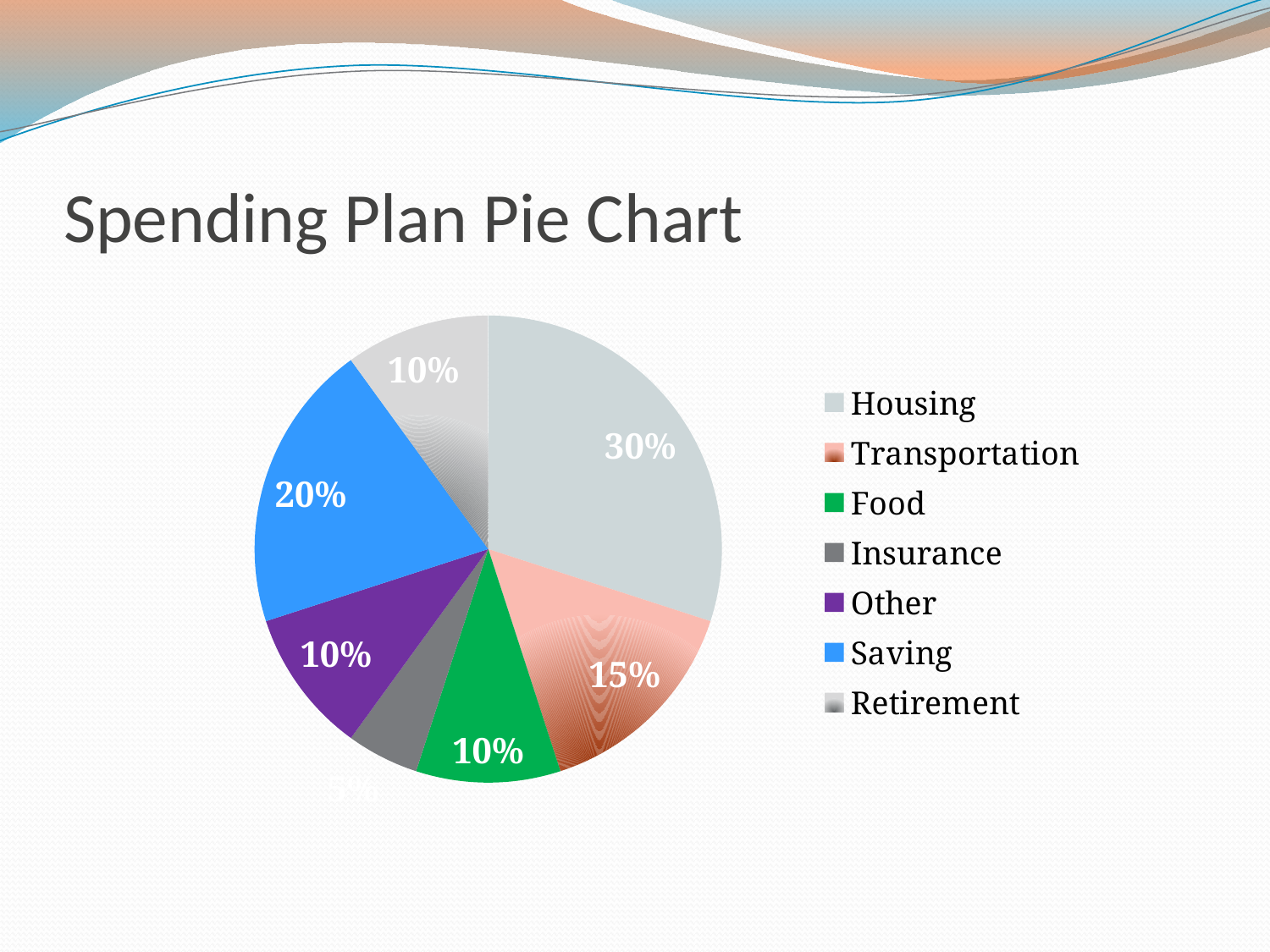
What share of the pie does Food take? 10% What share of the pie does Housing take? 30% What share of the pie does Saving take? 20% Which category has the largest slice of the pie? Housing Which category has the smallest slice of the pie? Insurance Which is larger, the Saving slice or the Transportation slice? Saving What is the title of the chart on the slide? Spending Plan Pie Chart What is the difference between the Housing share and the Saving share? 10% What kind of chart is shown on the slide? pie chart How many categories does the legend of the pie chart list? 7 What colour is the Saving slice in the pie chart? blue